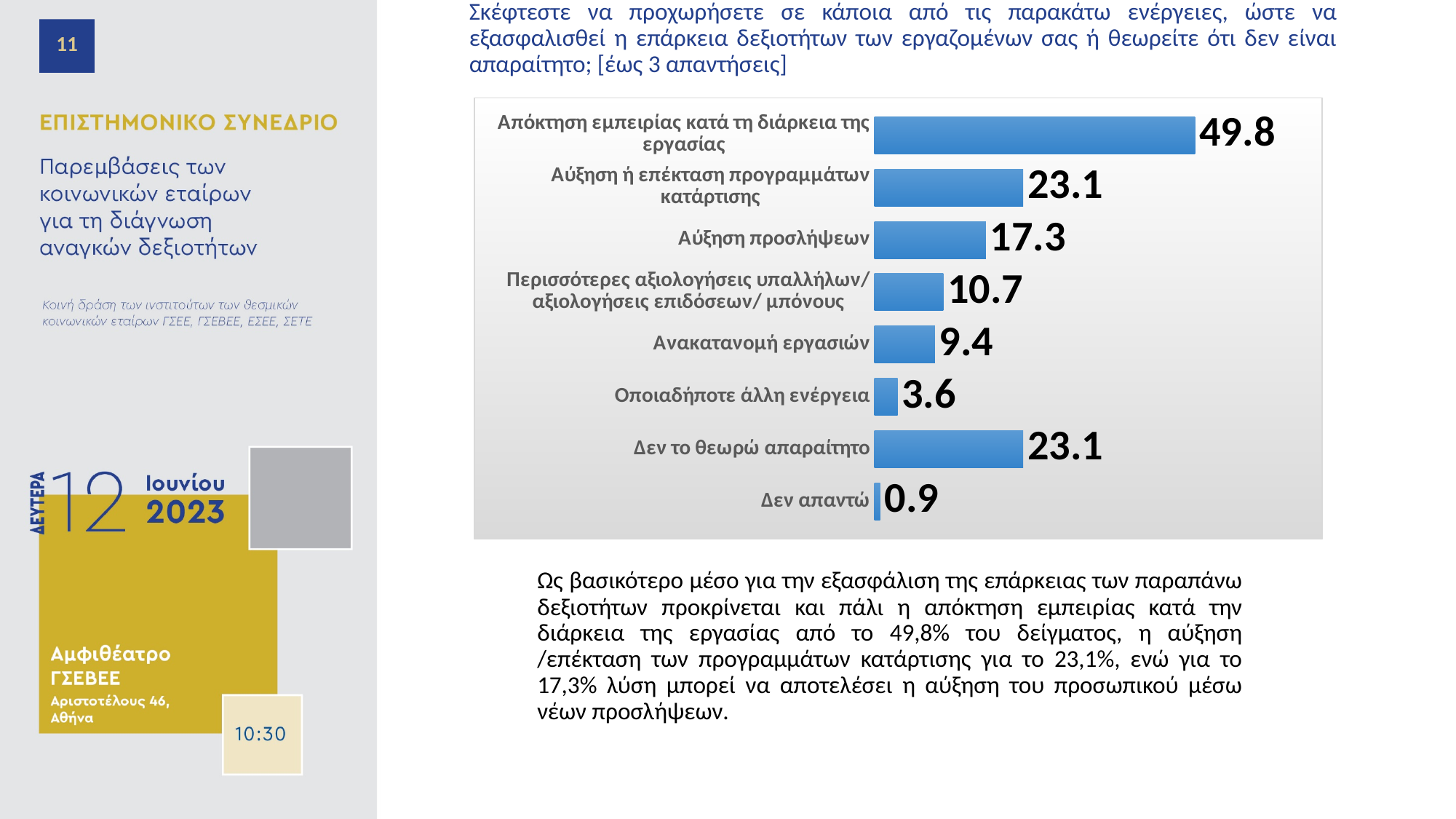
Which category has the lowest value in the chart? Δεν απαντώ Which is larger, the value for "Ανακατανομή εργασιών" or the value for "Οποιαδήποτε άλλη ενέργεια"? Ανακατανομή εργασιών What kind of chart is shown on the slide? Bar chart How many categories are shown in the chart? 8 Which category has the highest value in the chart? Απόκτηση εμπειρίας κατά τη διάρκεια της εργασίας What value is shown for "Ανακατανομή εργασιών"? 9.4 What value is shown for "Απόκτηση εμπειρίας κατά τη διάρκεια της εργασίας"? 49.8 What value is shown for "Οποιαδήποτε άλλη ενέργεια"? 3.6 What is the difference between the values for "Αύξηση προσλήψεων" and "Περισσότερες αξιολογήσεις υπαλλήλων/ αξιολογήσεις επιδόσεων/ μπόνους"? 6.6 What is the difference between the values for "Απόκτηση εμπειρίας κατά τη διάρκεια της εργασίας" and "Αύξηση ή επέκταση προγραμμάτων κατάρτισης"? 26.7 What value is shown for "Αύξηση προσλήψεων"? 17.3 What value is shown for "Δεν το θεωρώ απαραίτητο"? 23.1